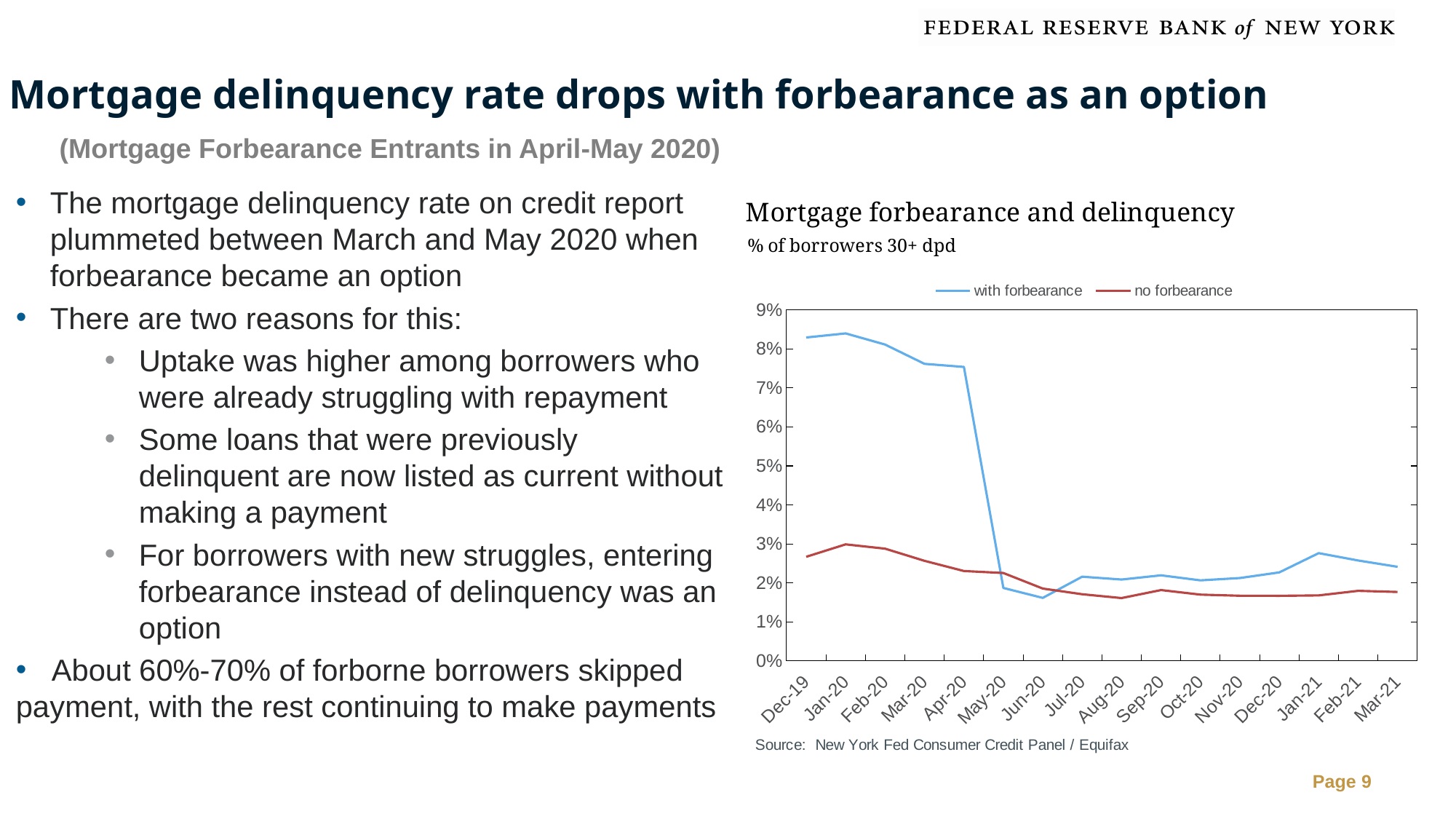
Is the value for 'with forbearance' in Dec-19 greater or less than 8%? greater What kind of chart is shown on the slide? line chart Does the 'with forbearance' series rise or fall between Apr-20 and May-20? fall Is the value for 'with forbearance' in Apr-20 greater or less than 7%? greater Is the value for 'no forbearance' in Dec-19 greater or less than 2%? greater How many months are plotted along the x axis of the chart? 16 In Dec-19, which series has the higher value, 'with forbearance' or 'no forbearance'? with forbearance How many series does the chart legend list? 2 Which series is drawn in red in the chart? no forbearance What is the title of the chart? Mortgage forbearance and delinquency